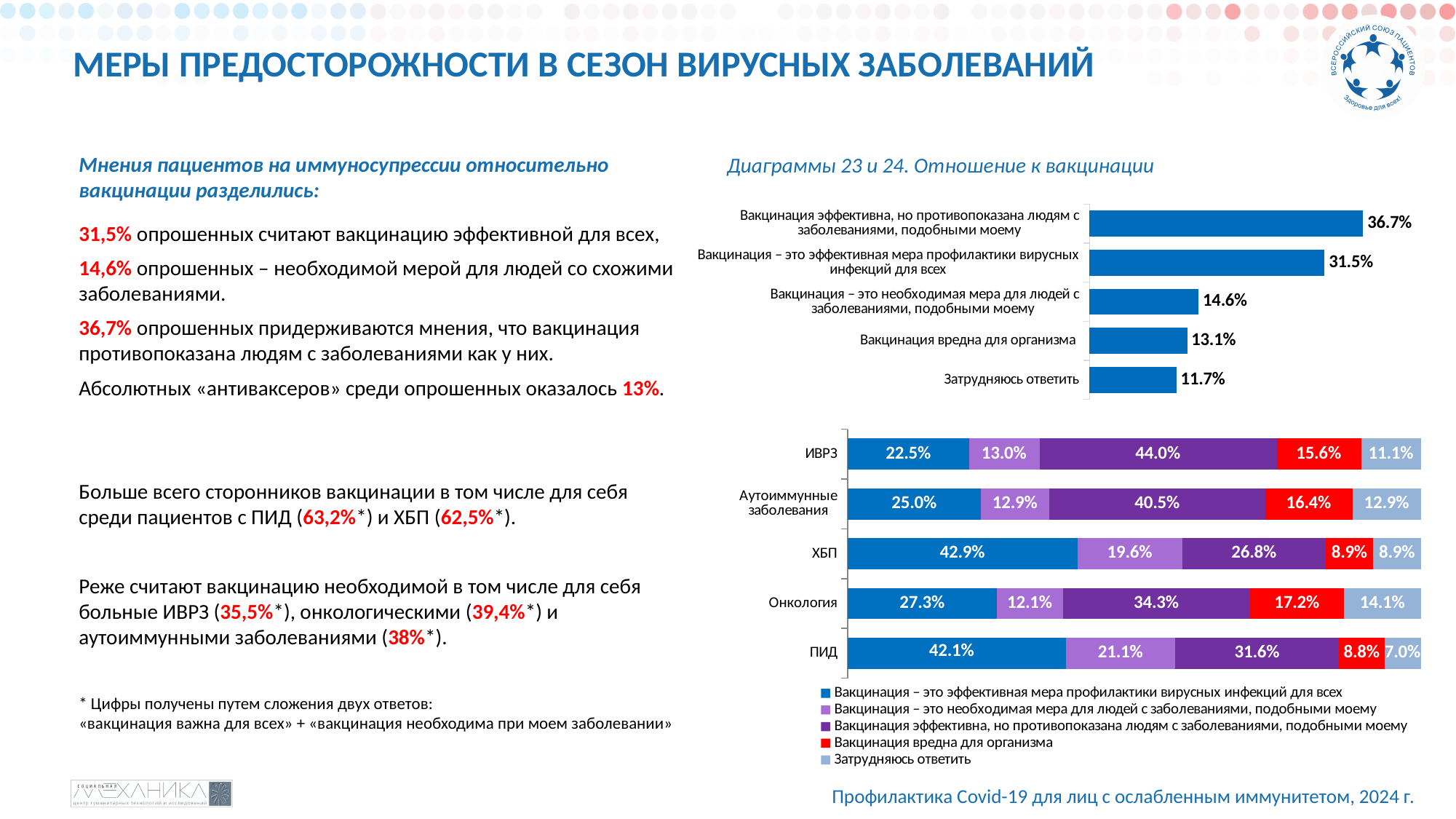
How many series does the legend of the bottom chart list? 5 In the top chart, what is the value for «Вакцинация вредна для организма»? 13.1% In the top chart, which category has the highest value? Вакцинация эффективна, но противопоказана людям с заболеваниями, подобными моему In the top chart, which category has the lowest value? Затрудняюсь ответить In the bottom chart, what is the value of «Вакцинация вредна для организма» for Онкология? 17.2% How many categories are shown in the top chart? 5 In the top chart, what is the difference between the values for «Вакцинация – это эффективная мера профилактики вирусных инфекций для всех» and «Вакцинация – это необходимая мера для людей с заболеваниями, подобными моему»? 16.9% In the bottom chart, what colour represents «Вакцинация вредна для организма»? Red In the bottom chart, which group has the highest value for «Вакцинация эффективна, но противопоказана людям с заболеваниями, подобными моему»? ИВРЗ In the bottom chart, which is larger: the «Затрудняюсь ответить» value for ПИД or for Онкология? Онкология In the bottom chart, what is the value of «Вакцинация – это эффективная мера профилактики вирусных инфекций для всех» for ХБП? 42.9% What type of chart is the top chart? Bar chart